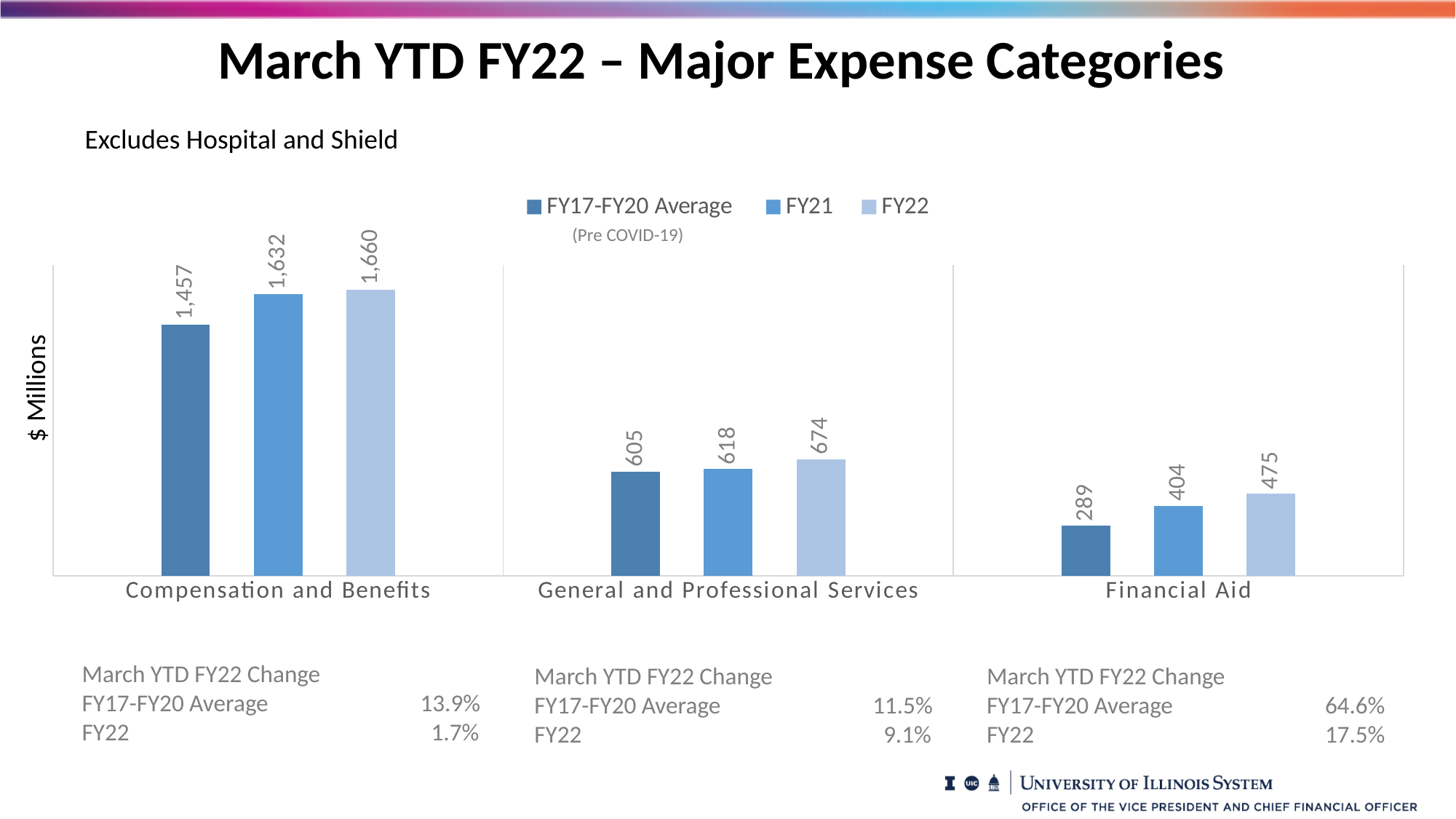
Which category has the highest FY22 value? Compensation and Benefits What is the FY21 value for General and Professional Services? 618 What is the FY22 value for Compensation and Benefits? 1,660 What is the difference between the FY22 and FY17-FY20 Average values for Compensation and Benefits? 203 What kind of chart is shown on the slide? Bar chart What is the FY17-FY20 Average value for Financial Aid? 289 How many expense categories are shown on the x axis? 3 What is the difference between the FY22 and FY21 values for Financial Aid? 71 Which is larger for General and Professional Services, the FY22 value or the FY17-FY20 Average value? FY22 What is the unit shown on the y axis label? $ Millions Which category has the lowest FY17-FY20 Average value? Financial Aid How many series does the legend list? 3